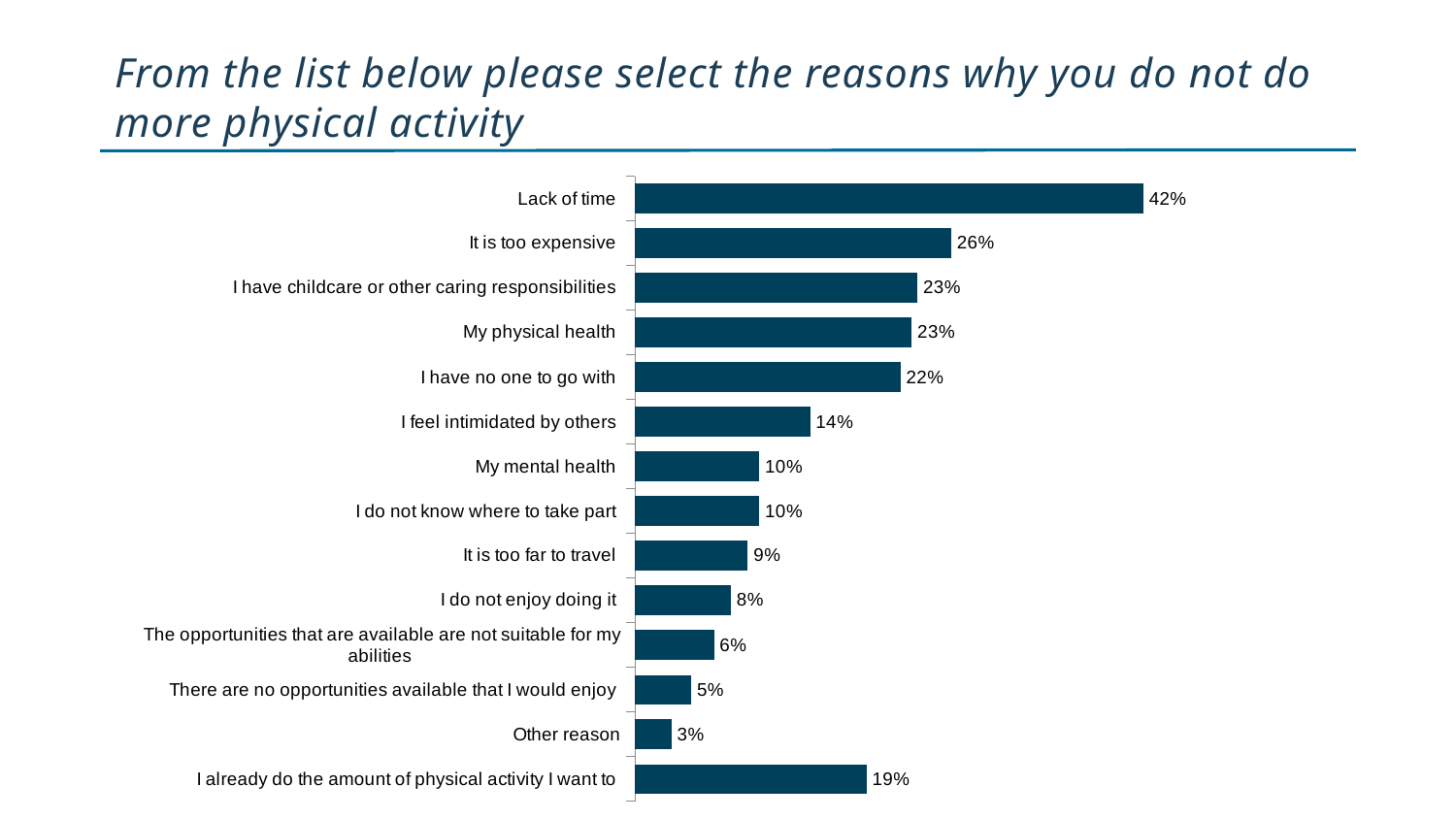
What is the value shown for 'It is too expensive'? 26% What is the value for 'I feel intimidated by others'? 14% What kind of chart is shown on the slide? Bar chart How many reasons (categories) are shown in the chart? 14 Which reason has the lowest percentage? Other reason What is the difference between the values for 'Lack of time' and 'It is too expensive'? 16% Which is larger: the value for 'It is too far to travel' or 'I do not enjoy doing it'? It is too far to travel What is the value shown for 'There are no opportunities available that I would enjoy'? 5% What percentage is shown for 'I already do the amount of physical activity I want to'? 19% What percentage of respondents selected 'Lack of time' as a reason for not doing more physical activity? 42% What is the difference between 'I have no one to go with' and 'Other reason'? 19% Which reason has the highest percentage? Lack of time